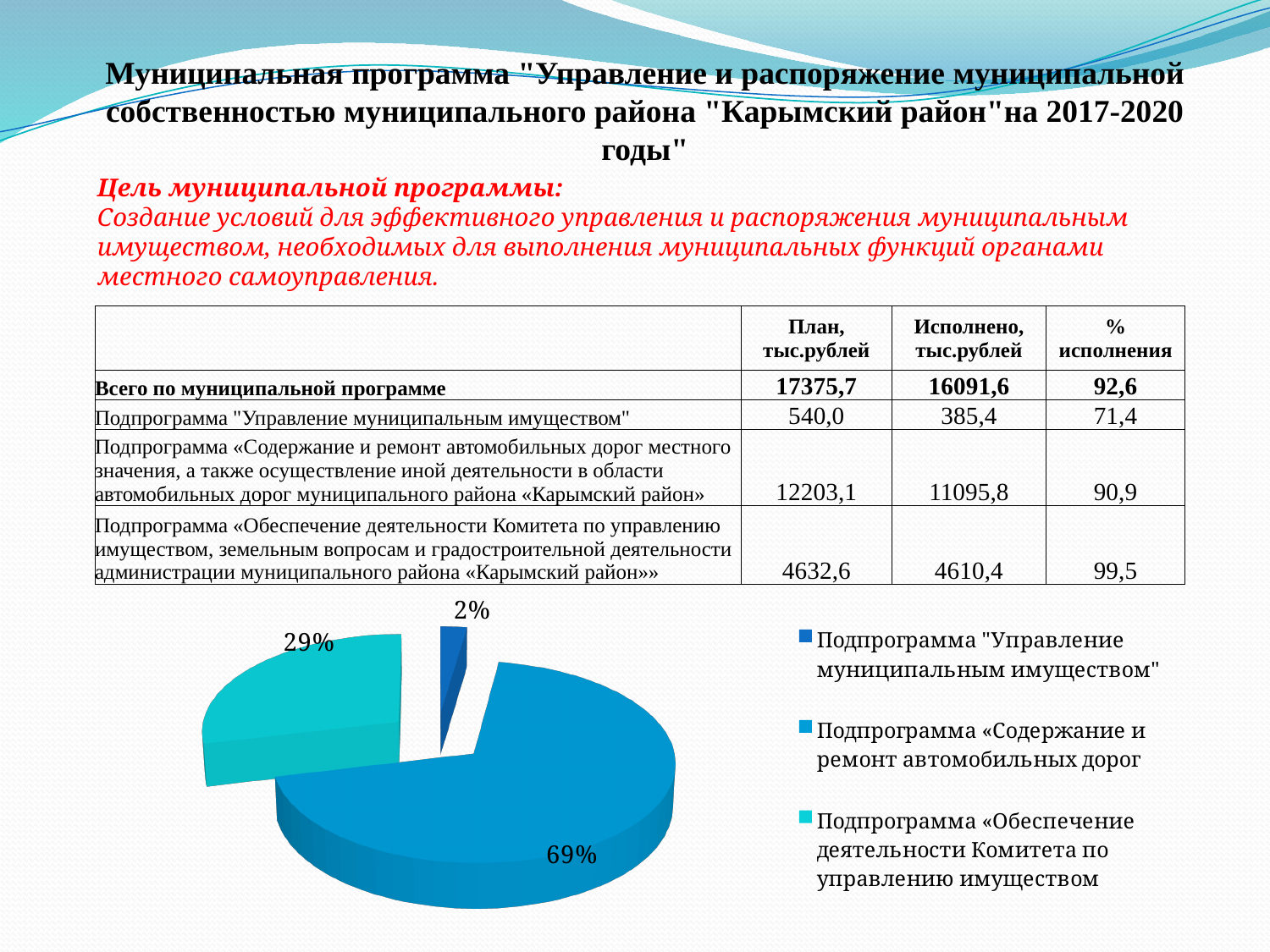
How many slices does the pie chart have? 3 What share of the pie does the slice for Подпрограмма «Содержание и ремонт автомобильных дорог» represent? 69% What share of the pie does the slice for Подпрограмма «Обеспечение деятельности Комитета по управлению имуществом» represent? 29% Which subprogram has the largest slice in the pie chart? Подпрограмма «Содержание и ремонт автомобильных дорог» What kind of chart is shown at the bottom of the slide? Pie chart Which subprogram has the smallest slice in the pie chart? Подпрограмма "Управление муниципальным имуществом" How many entries does the legend of the pie chart list? 3 In the pie chart, what is the difference in percentage points between the largest slice and the 29% slice? 40 Where is the legend positioned relative to the pie chart? To the right What share of the pie does the slice for Подпрограмма "Управление муниципальным имуществом" represent? 2% In the pie chart, which slice is larger: Подпрограмма «Обеспечение деятельности Комитета по управлению имуществом» or Подпрограмма "Управление муниципальным имуществом"? Подпрограмма «Обеспечение деятельности Комитета по управлению имуществом» What colour is the slice for Подпрограмма «Обеспечение деятельности Комитета по управлению имуществом» in the pie chart? Cyan (light blue)